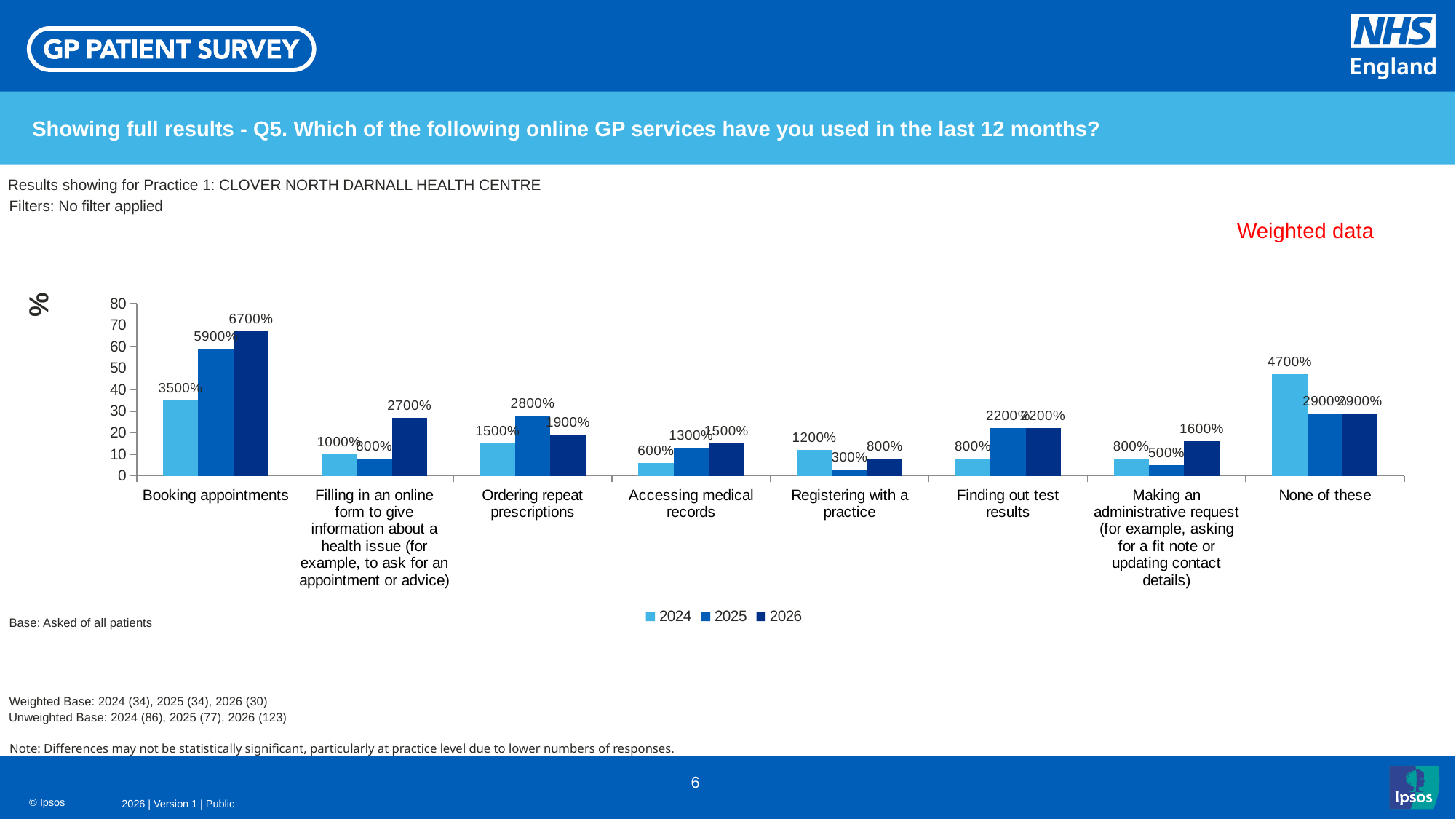
Which category has the lowest value in 2024? Accessing medical records What is the value for None of these in 2024? 4700% How many series does the legend list? 3 Which is larger for Making an administrative request: the 2024 value or the 2026 value? 2026 What is the value for Registering with a practice in 2025? 300% What is the difference between the 2026 and 2024 values for Booking appointments? 3200% What is the value for Booking appointments in 2026? 6700% What is the value for Ordering repeat prescriptions in 2025? 2800% Which category has the highest value in 2026? Booking appointments Do the values for Booking appointments rise or fall from 2024 to 2026? Rise What kind of chart is shown on the slide? Bar chart How many categories are shown on the x axis? 8